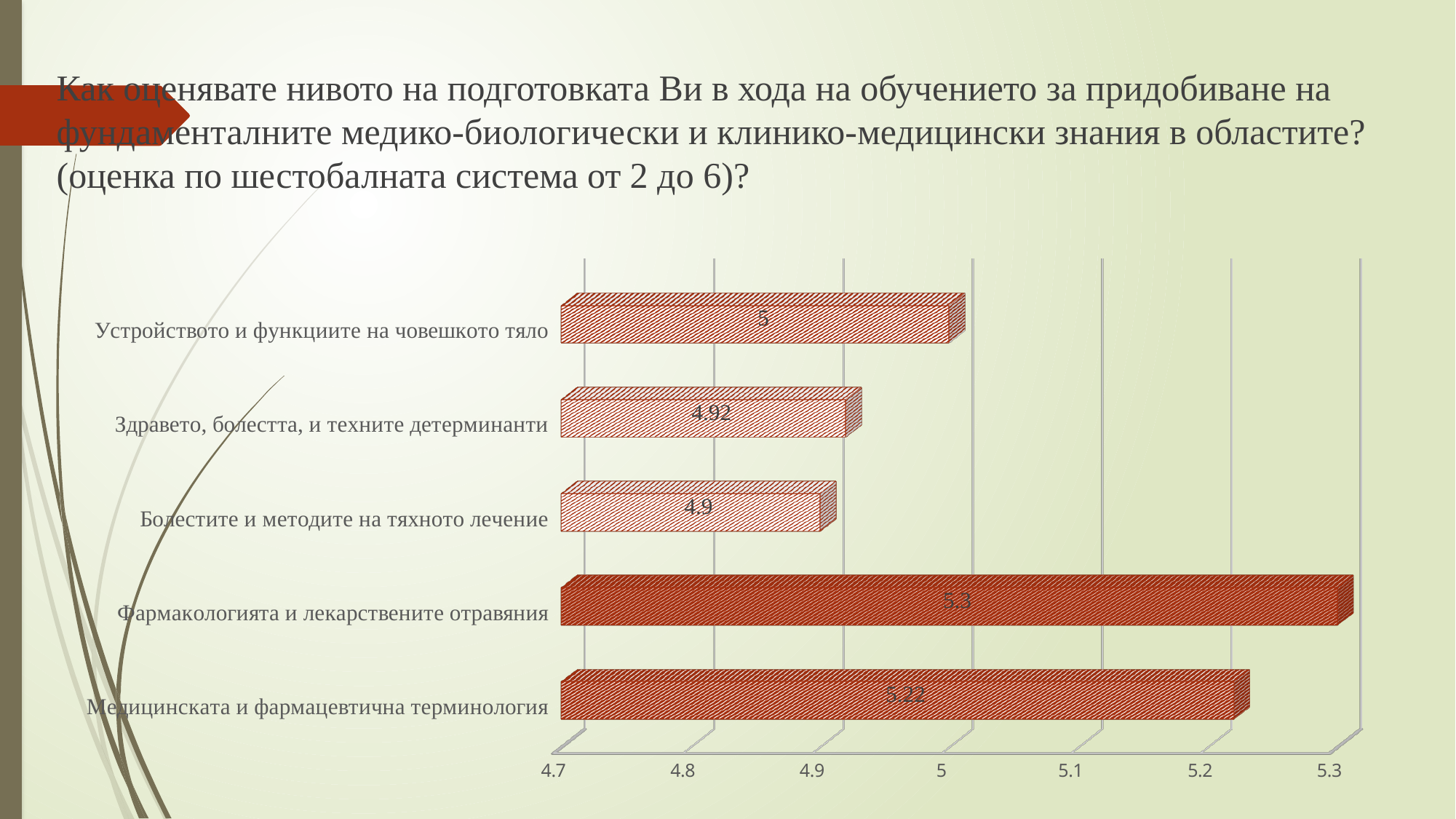
What is the value for "Фармакологията и лекарствените отравяния"? 5.3 Which is larger: the value for "Здравето, болестта, и техните детерминанти" or for "Устройството и функциите на човешкото тяло"? Устройството и функциите на човешкото тяло What is the difference between the values for "Фармакологията и лекарствените отравяния" and "Медицинската и фармацевтична терминология"? 0.08 Is the value for "Медицинската и фармацевтична терминология" greater or less than 5.2? greater What is the highest value shown on the horizontal axis? 5.3 What is the value for "Здравето, болестта, и техните детерминанти"? 4.92 What is the value for "Устройството и функциите на човешкото тяло"? 5 Which category has the lowest value? Болестите и методите на тяхното лечение What kind of chart is shown on the slide? bar chart What is the value for "Медицинската и фармацевтична терминология"? 5.22 How many categories are shown in the chart? 5 Which category has the highest value? Фармакологията и лекарствените отравяния